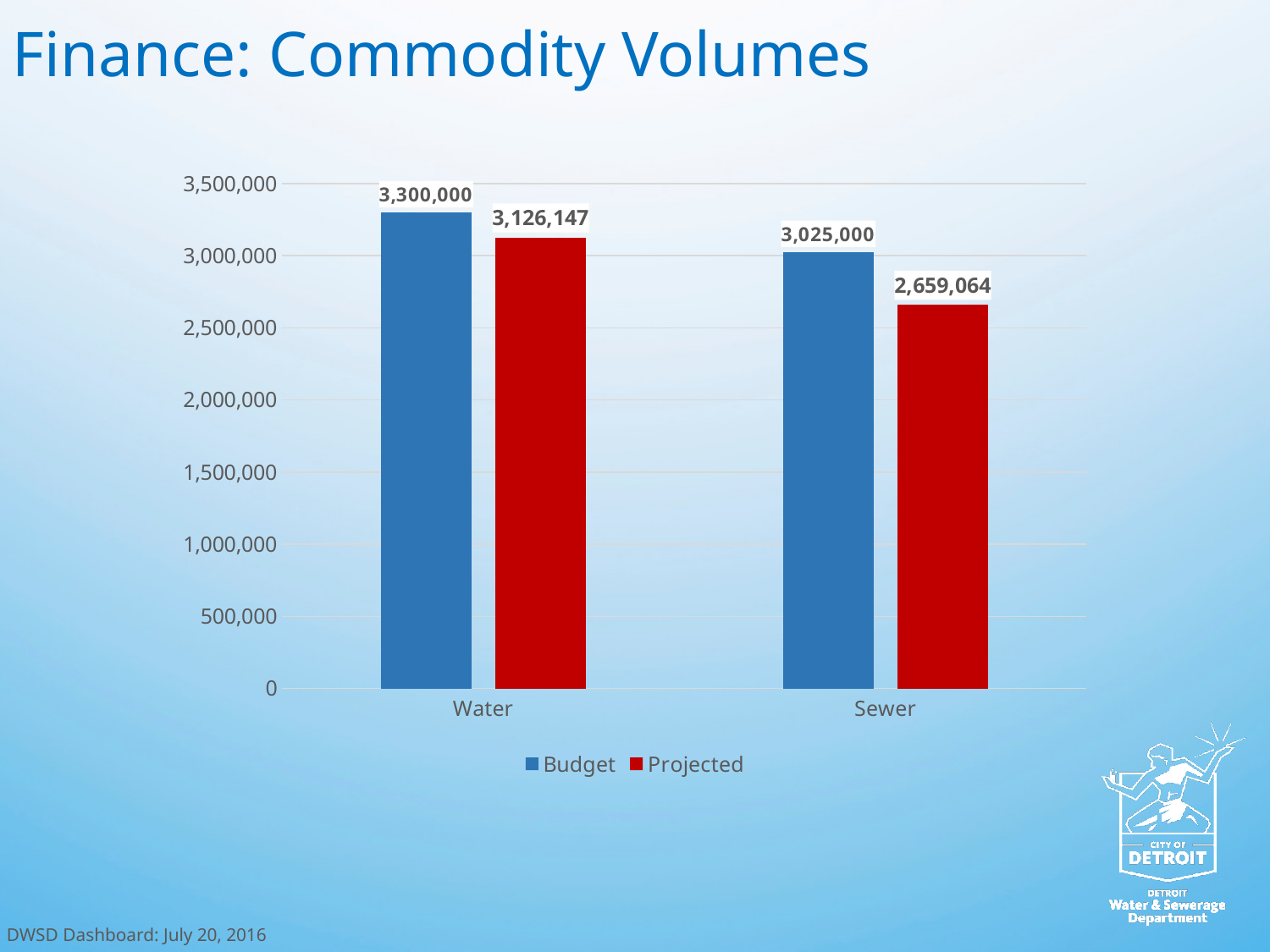
What is the Budget value for Water? 3,300,000 What is the Projected value for Water? 3,126,147 How many series does the legend list? 2 What is the difference between the Budget and Projected values for Sewer? 365,936 How many categories are shown on the x axis? 2 What is the Budget value for Sewer? 3,025,000 Which bar has the highest value on the chart? Water Budget What is the Projected value for Sewer? 2,659,064 What kind of chart is shown on the slide? Bar chart Which is larger, the Projected value for Water or the Budget value for Sewer? Projected value for Water What is the difference between the Budget and Projected values for Water? 173,853 Which bar has the lowest value on the chart? Sewer Projected